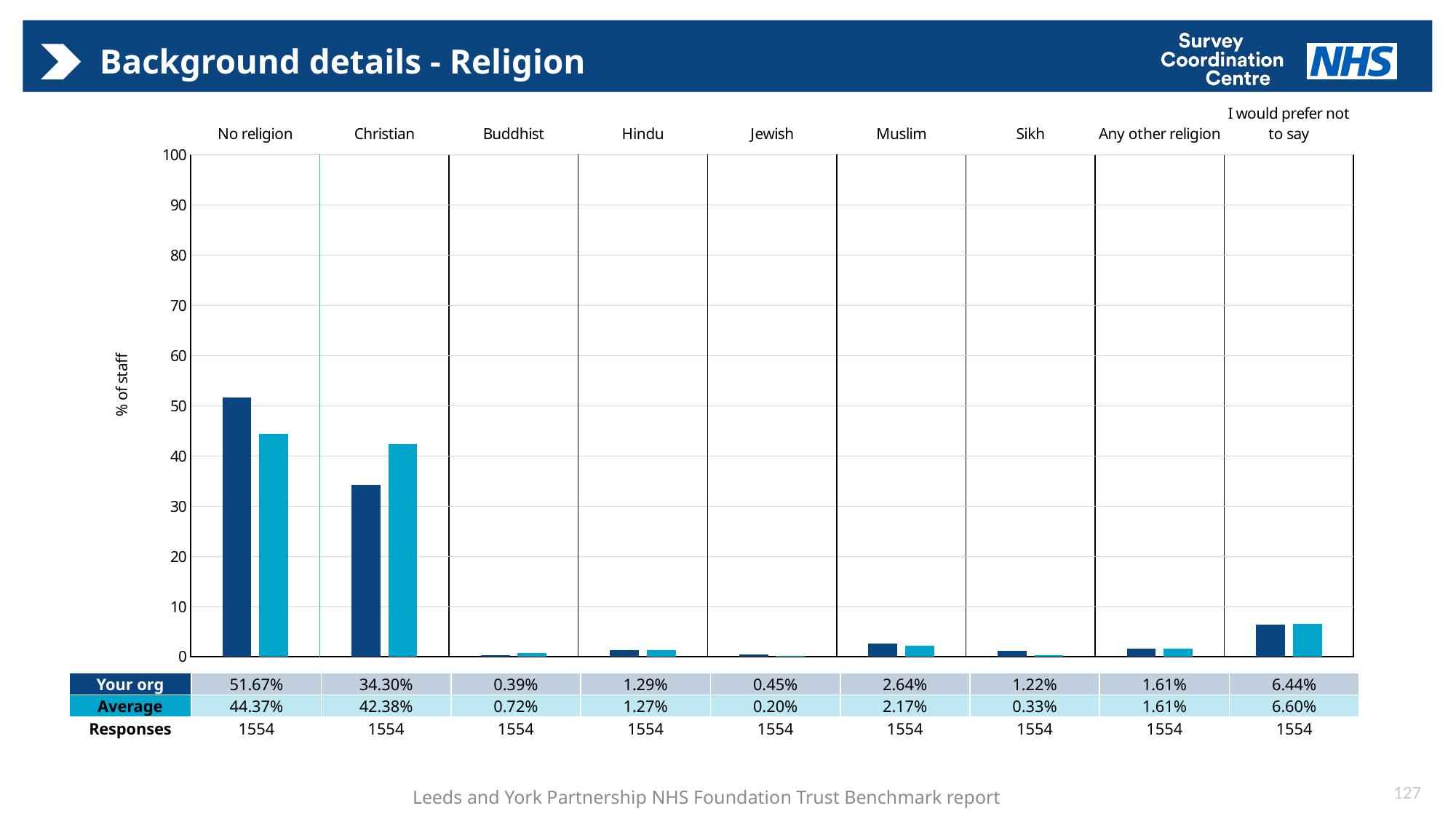
What kind of chart is shown on the slide? Bar chart How many religion categories are shown on the chart? 9 Which is larger for Christian: the 'Your org' value or the Average value? Average What is the 'Your org' value for No religion? 51.67% How many series does the chart show? 2 What is the difference between the 'Your org' and Average values for No religion? 7.30% What is the Average value for Christian? 42.38% What is the number of responses for the Sikh category? 1554 Which religion category has the highest 'Your org' value? No religion Which religion category has the lowest Average value? Jewish What is the 'Your org' value for Muslim? 2.64% Is the 'Your org' value for No religion greater or less than 50? greater